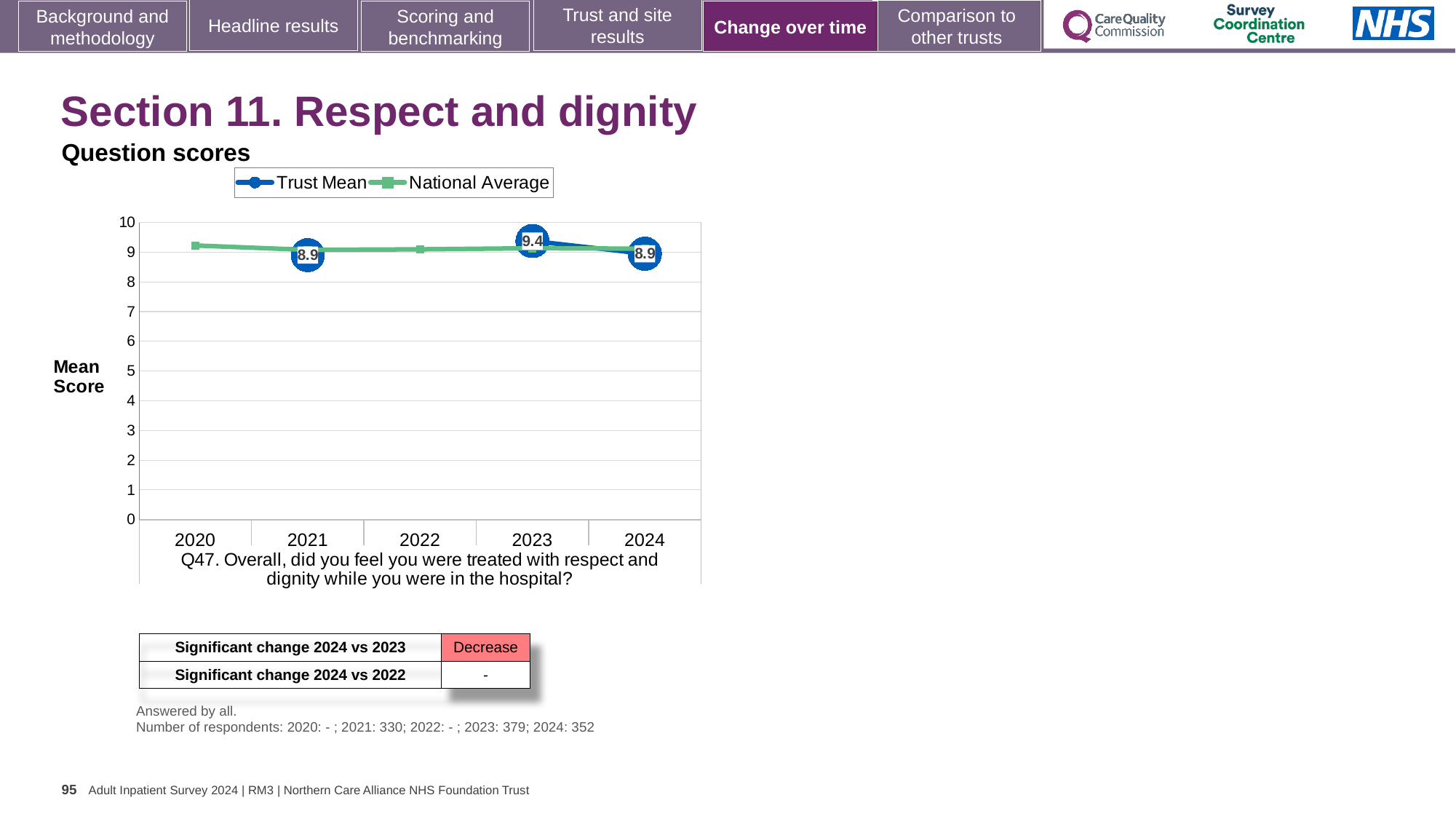
What is the Trust Mean value for 2021? 8.9 Does the Trust Mean rise or fall from 2023 to 2024? Fall How many years are shown on the x axis? 5 What is the difference between the Trust Mean in 2023 and in 2024? 0.5 In which year is the Trust Mean highest? 2023 Which is larger, the Trust Mean for 2023 or for 2021? 2023 What kind of chart is shown on the slide? Line chart What is the Trust Mean value for 2024? 8.9 How many series does the legend list? 2 Is the National Average value for 2020 greater or less than 8? greater What is the label on the y axis of the chart? Mean Score What is the Trust Mean value for 2023? 9.4